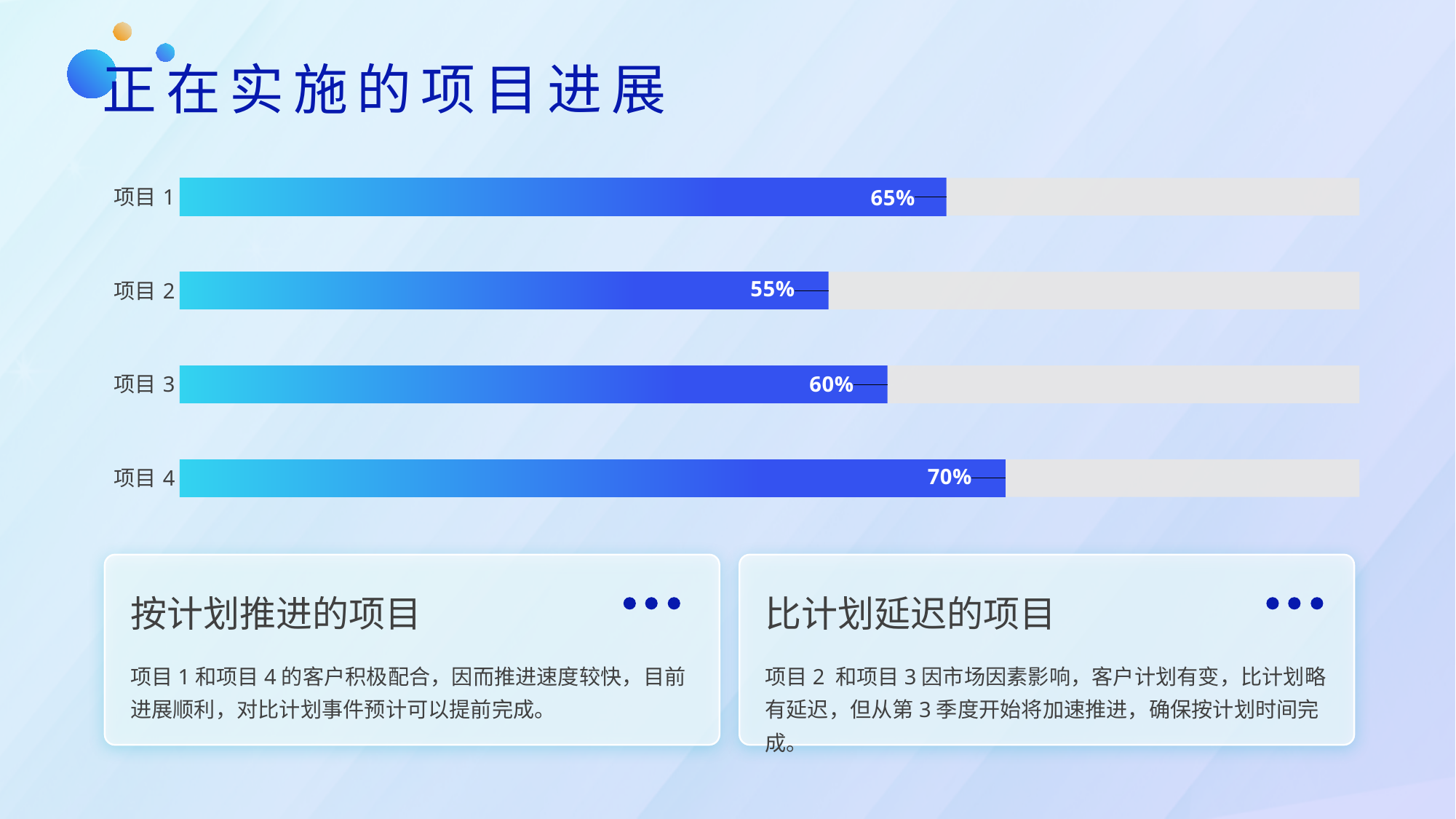
What is the value for 项目 2? 55% What is the title of the slide? 正在实施的项目进展 What is the value for 项目 4? 70% Which project has the highest value? 项目 4 What is the value for 项目 1? 65% Which is larger, the value for 项目 1 or the value for 项目 3? 项目 1 Which project has the lowest value? 项目 2 What is the difference between the values for 项目 1 and 项目 3? 5% What is the difference between the values for 项目 4 and 项目 2? 15% What is the value for 项目 3? 60% What kind of chart is shown on the slide? Bar chart How many projects are shown in the chart? 4